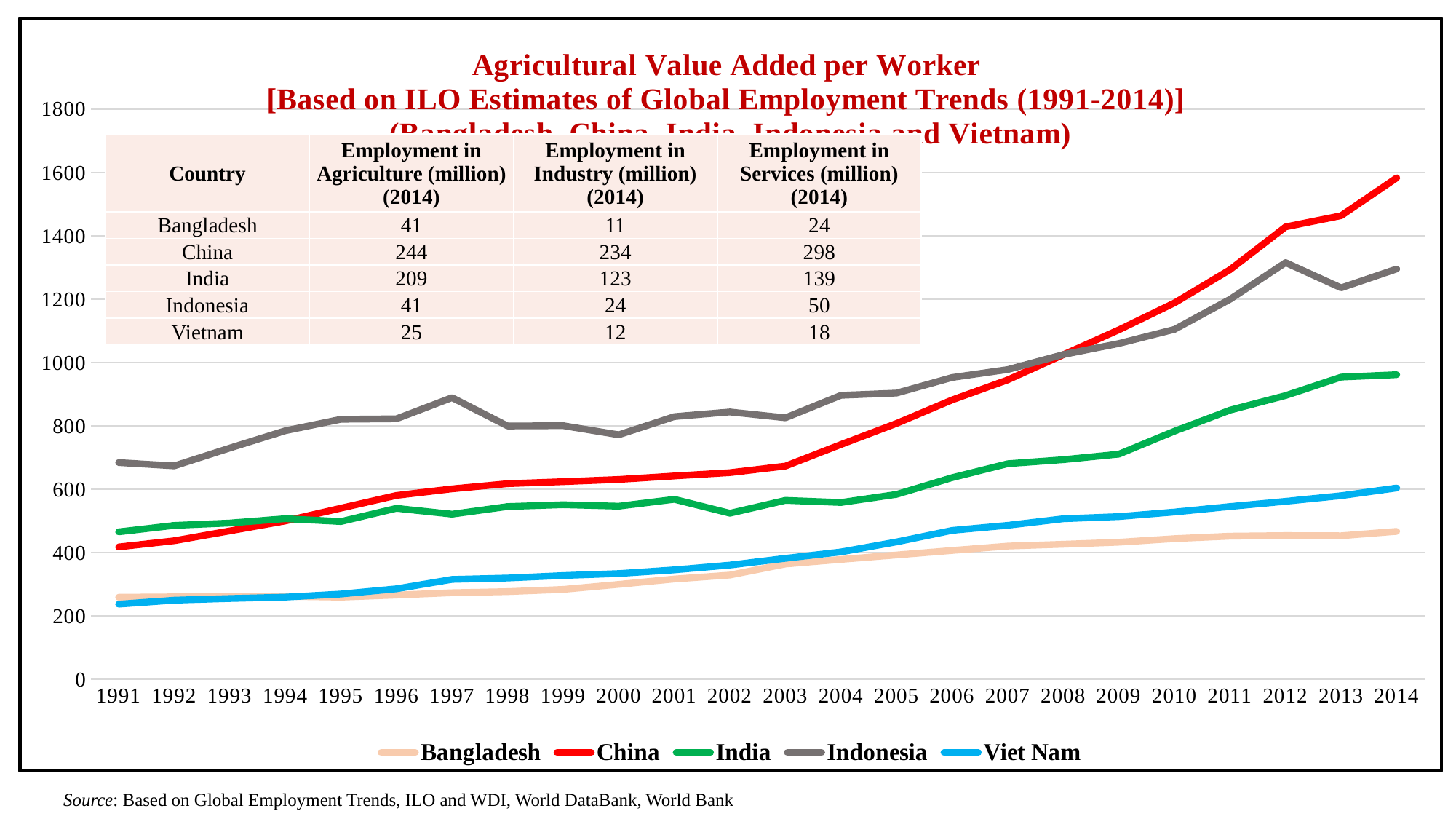
In 1991, which is larger: the value for Indonesia or the value for China? Indonesia Is the value for Bangladesh in 2014 greater or less than 600? less What kind of chart is shown on the slide? line chart Is the value for Indonesia in 1991 greater or less than 600? greater How many years are shown along the x axis of the chart? 24 Which country has the lowest agricultural value added per worker in 2014? Bangladesh Which country has the highest agricultural value added per worker in 1991? Indonesia Is the value for China in 2014 greater or less than 1400? greater Does the line for China rise or fall from 1991 to 2014? rise How many series does the legend of the chart list? 5 In 2014, which is larger: the value for India or the value for Viet Nam? India Which country has the highest agricultural value added per worker in 2014? China